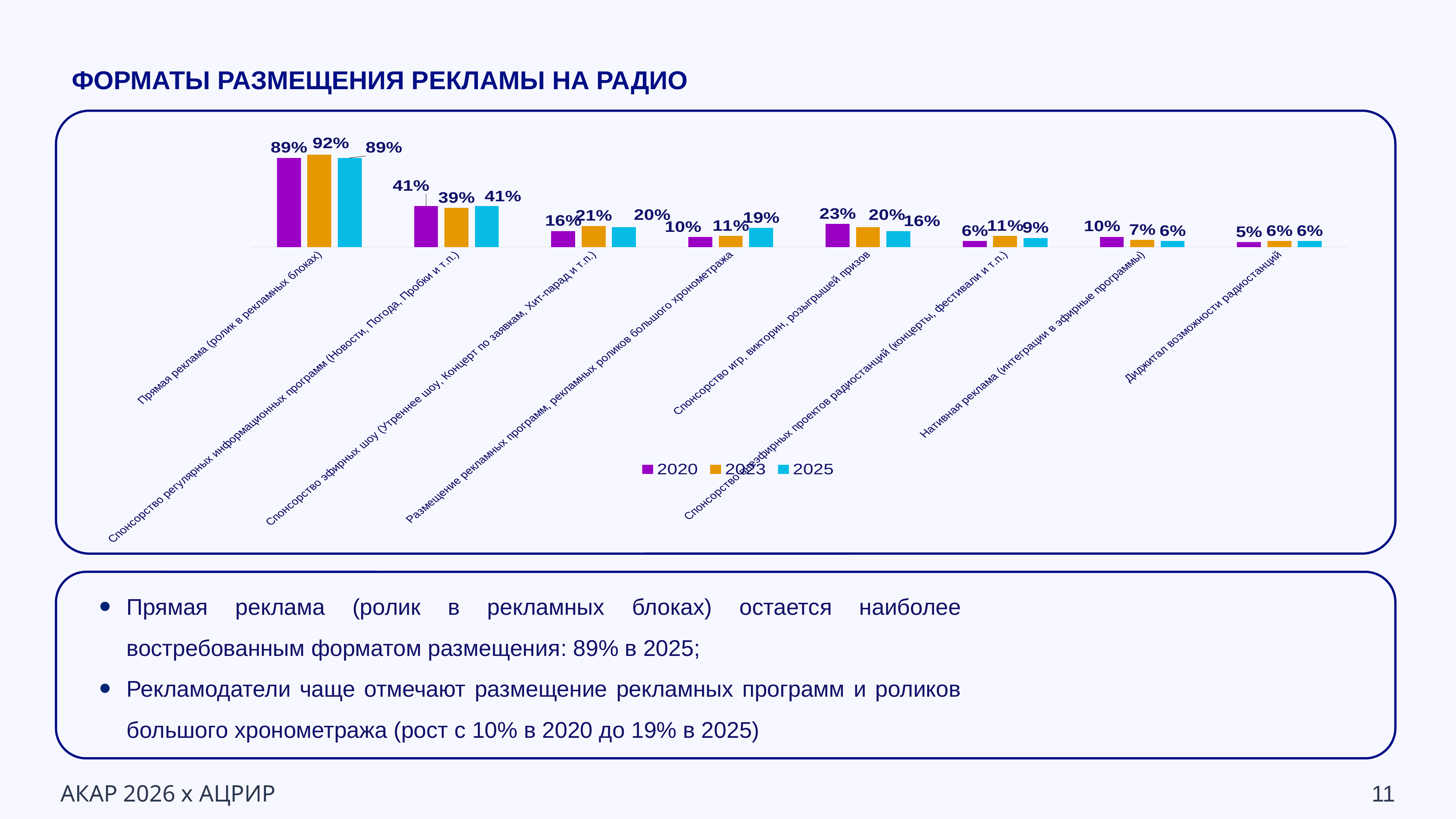
What is the 2025 value for Размещение рекламных программ, рекламных роликов большого хронометража? 19% Which category has the lowest 2020 value? Диджитал возможности радиостанций What is the 2025 value for Прямая реклама (ролик в рекламных блоках)? 89% What is the difference between the 2025 and 2020 values for Размещение рекламных программ, рекламных роликов большого хронометража? 9% What is the 2020 value for Спонсорство игр, викторин, розыгрышей призов? 23% What type of chart is shown on the slide? bar chart Which is larger for Спонсорство эфирных шоу: the 2020 value or the 2023 value? 2023 How many categories (advertising formats) are shown on the x axis? 8 Do the values for Спонсорство игр, викторин, розыгрышей призов rise or fall from 2020 to 2025? fall How many series does the legend list? 3 What is the 2023 value for Прямая реклама (ролик в рекламных блоках)? 92% Which category has the highest 2025 value? Прямая реклама (ролик в рекламных блоках)